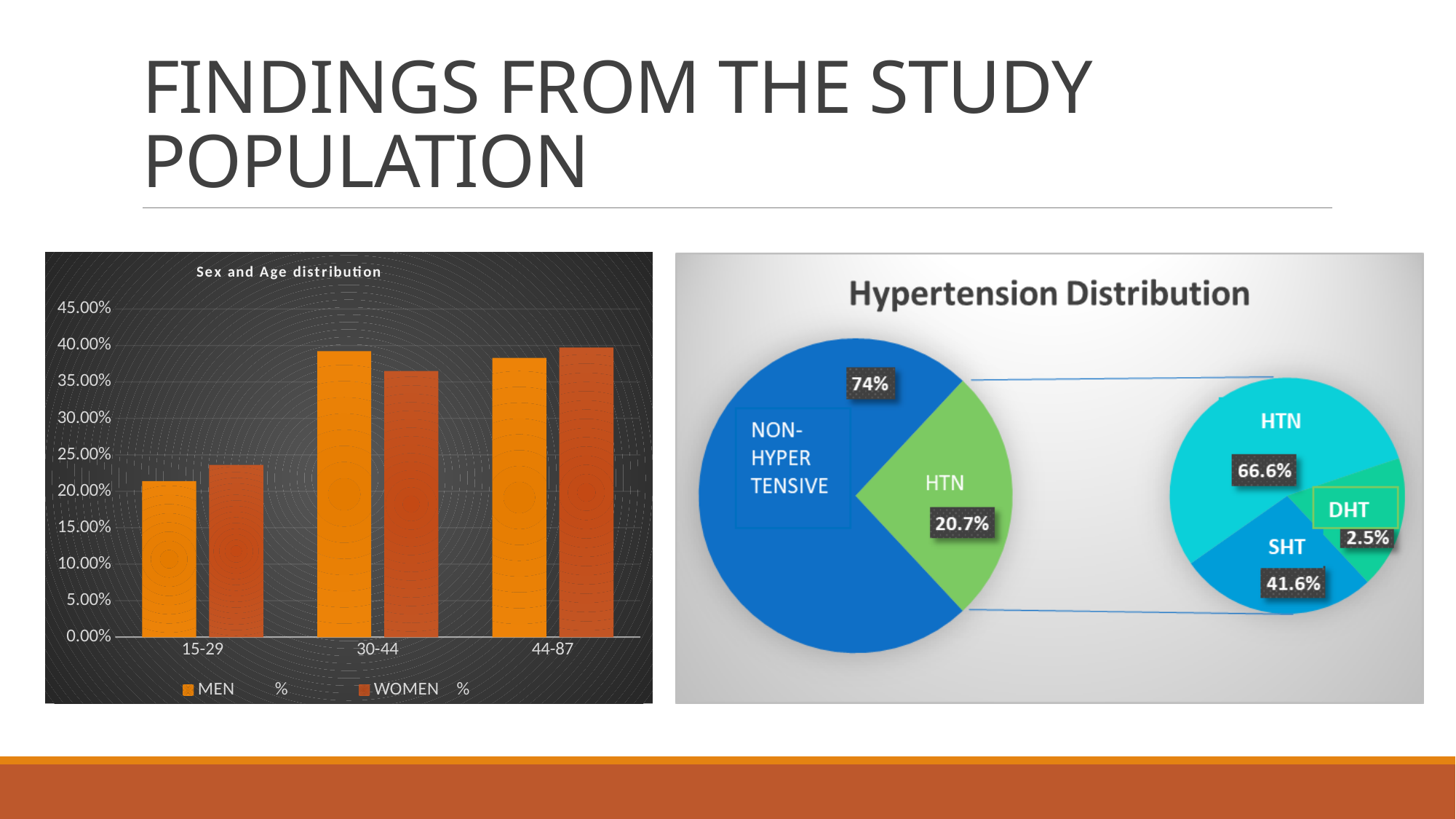
In the 'Sex and Age distribution' chart, how many series does the legend list? 2 In the 'Sex and Age distribution' chart, is the value for WOMEN in the 30-44 group greater or less than 35.00%? greater In the 'Hypertension Distribution' chart, what value is shown for DHT in the smaller pie? 2.5% In the 'Sex and Age distribution' chart, how many age groups are shown on the x axis? 3 In the 'Sex and Age distribution' chart, which age group has the highest value for WOMEN? 44-87 What kind of chart is the 'Sex and Age distribution' chart on the left? bar chart In the 'Hypertension Distribution' chart, what value is shown for HTN in the main pie? 20.7% In the 'Hypertension Distribution' chart, what share of the main pie is NON-HYPERTENSIVE? 74% In the 'Sex and Age distribution' chart, is the value for MEN in the 15-29 group greater or less than 25.00%? less What kind of chart is the 'Hypertension Distribution' chart on the right? pie chart In the 'Sex and Age distribution' chart, which age group has the lowest value for MEN? 15-29 In the 'Sex and Age distribution' chart, for the 30-44 group, which is larger: MEN or WOMEN? MEN